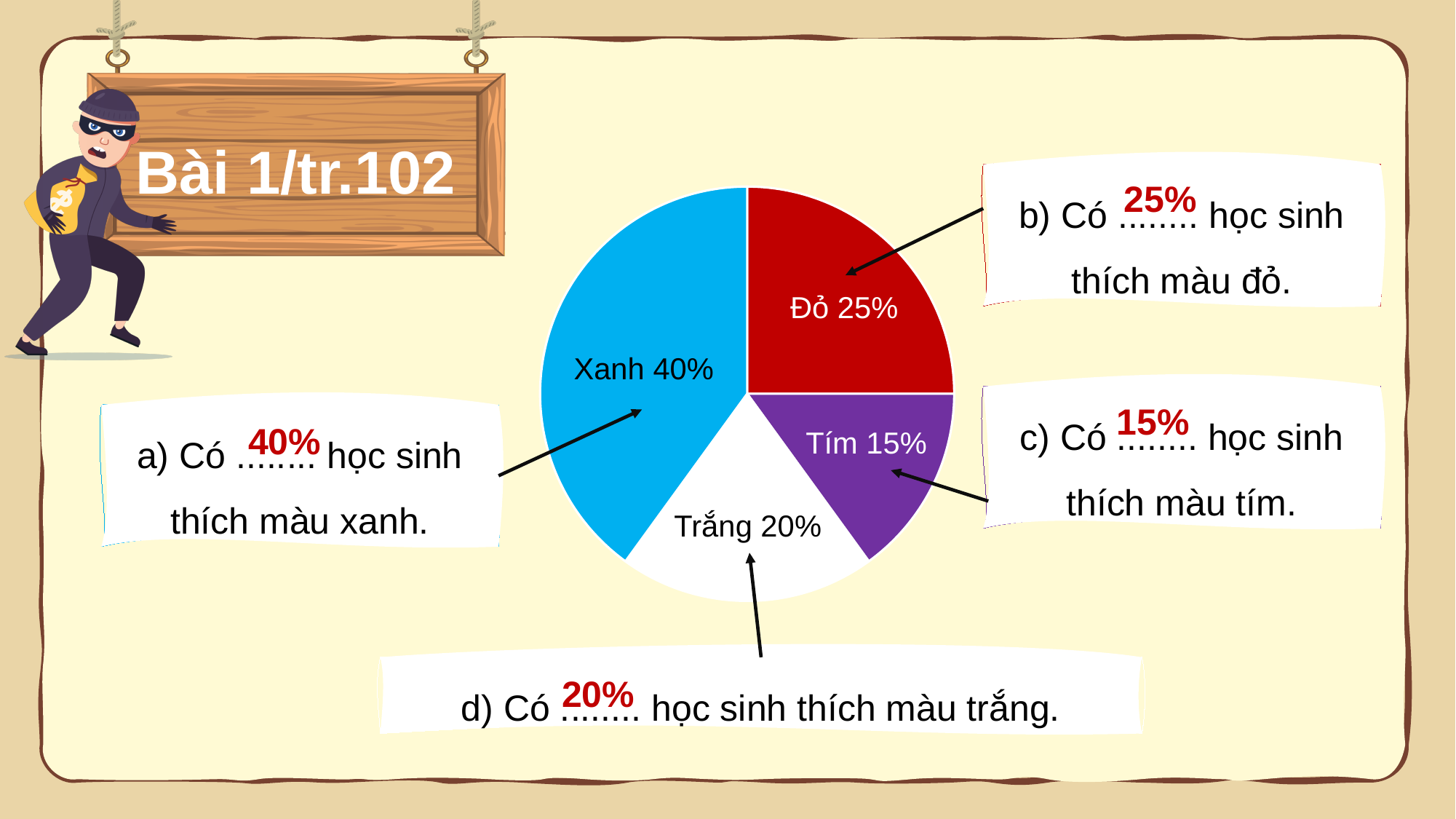
Which colour has the smallest share of the pie? Tím What is the difference between the share for Xanh and the share for Tím? 25% What kind of chart is shown on the slide? pie chart Which colour has the largest share of the pie? Xanh What colour is the slice labelled Tím 15% drawn in? purple What percentage of students like the colour Trắng (white)? 20% What is the combined share of Đỏ and Tím? 40% What percentage of students like the colour Tím (purple)? 15% What percentage of students like the colour Xanh (blue)? 40% How many slices does the pie chart have? 4 What percentage of students like the colour Đỏ (red)? 25% Which is larger, the share for Đỏ or the share for Trắng? Đỏ